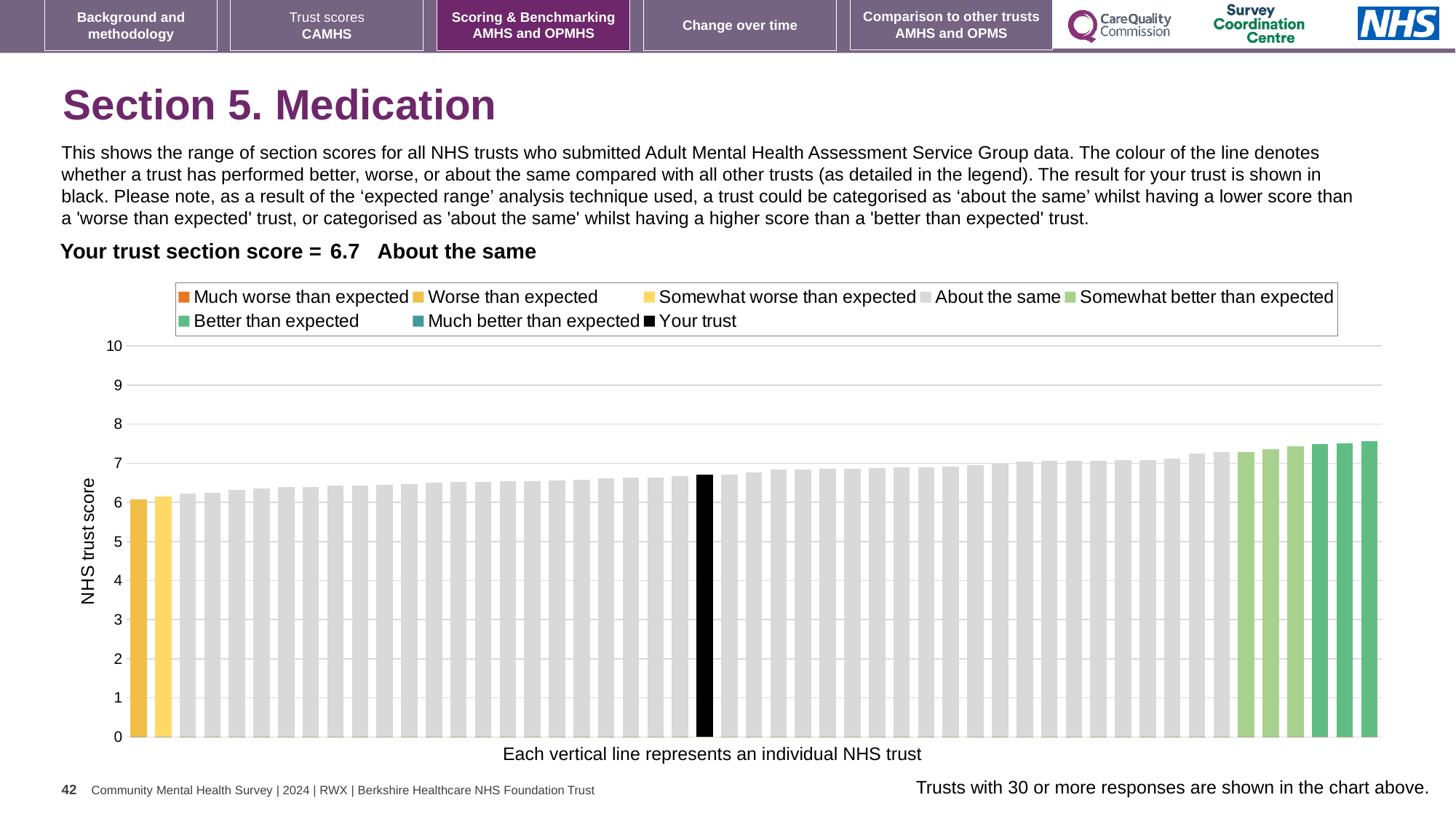
Do the bar values rise or fall from left to right along the x axis? rise Which category is your trust's section score placed in? About the same How many entries does the chart legend list? 8 Is the value of the leftmost (lowest) bar greater or less than 5? greater Is the value of the rightmost (highest) bar greater or less than 8? less What is the label on the vertical axis of the chart? NHS trust score Which is larger: the black 'Your trust' bar or the leftmost yellow bar? Your trust What does the caption below the x axis say each vertical line represents? an individual NHS trust How many bars are coloured in the 'Worse than expected' yellow? 1 What kind of chart is shown on the slide? bar chart Is the value of the black 'Your trust' bar greater or less than 7? less What is the section score for your trust shown on the slide? 6.7